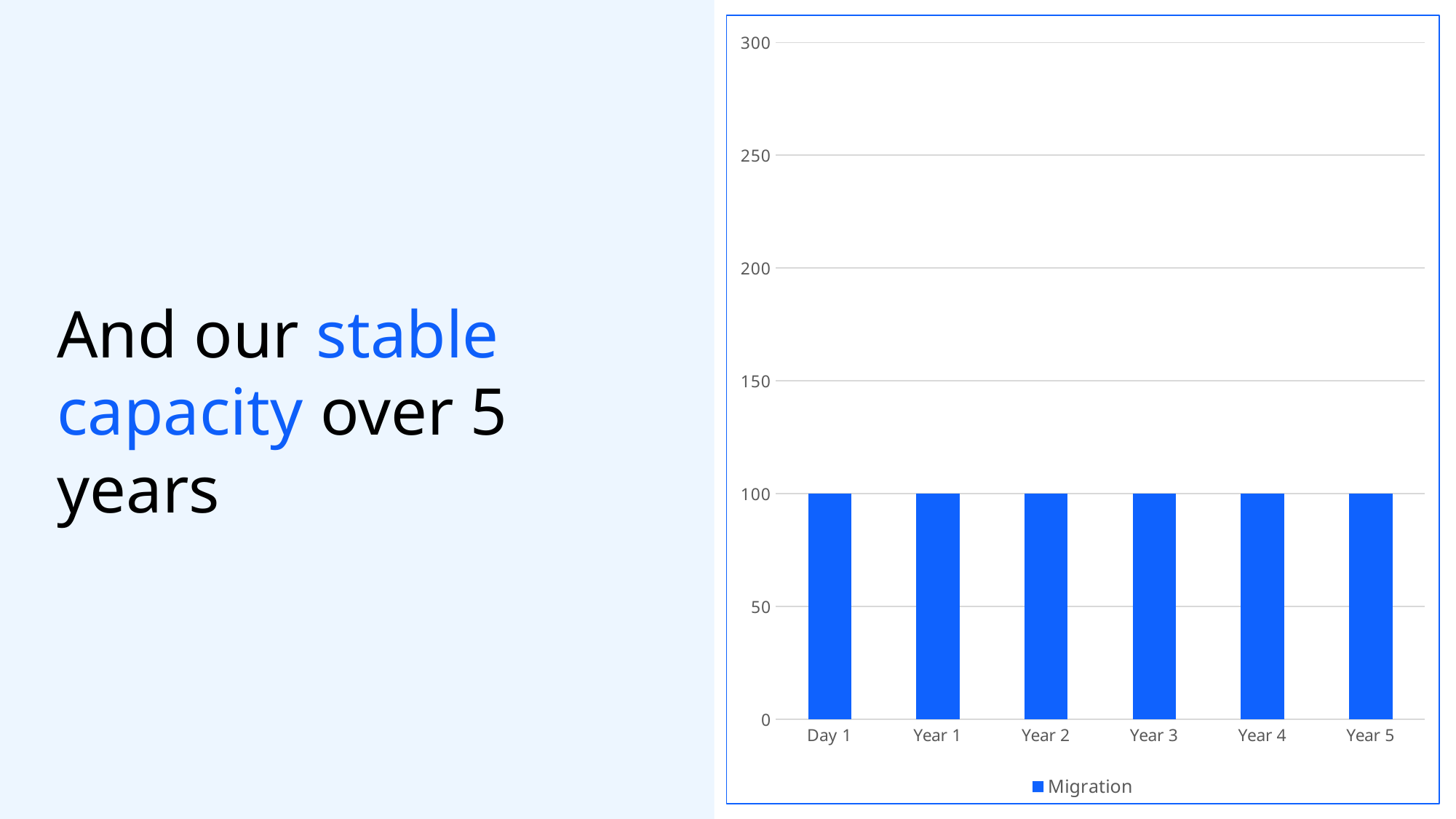
Is the Migration value for Year 2 greater or less than 150? less What is the difference between the Migration values for Year 1 and Year 5? 0 How many series does the chart's legend list? 1 What is the highest value labelled on the chart's vertical axis? 300 What is the Migration value for Year 3? 100 What is the Migration value for Day 1? 100 What is the name of the series shown in the chart's legend? Migration What is the Migration value for Year 5? 100 What kind of chart is shown on the slide? bar chart How many categories are shown on the x axis of the chart? 6 Do the Migration values rise, fall, or stay flat from Day 1 to Year 5? stay flat Is the Migration value for Year 4 greater or less than 50? greater